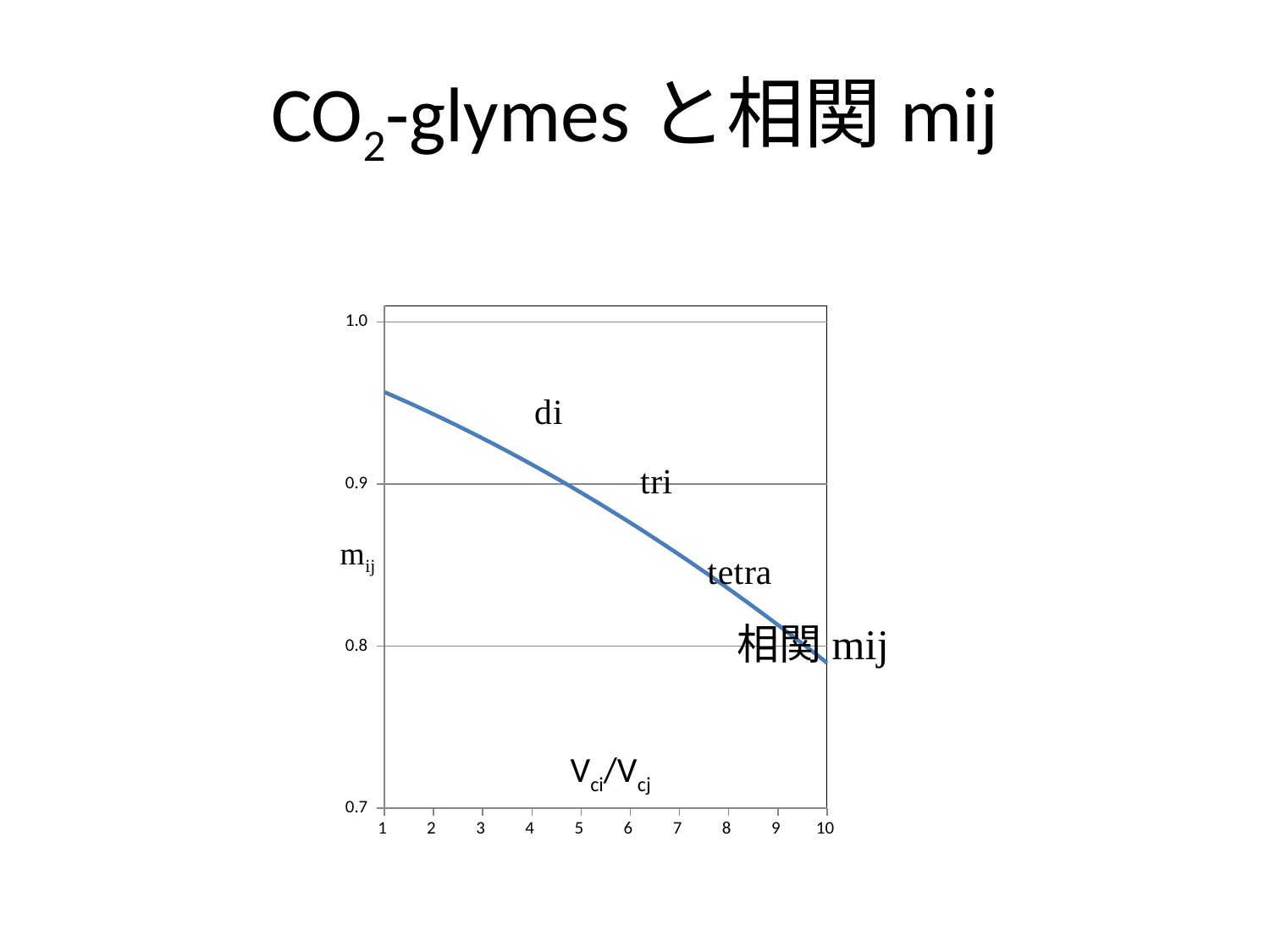
Does the plotted curve rise or fall as V_ci/V_cj increases from 1 to 10? fall Which three text annotations are placed along the curve in the chart? di, tri, tetra Is the value of m_ij at V_ci/V_cj = 7 greater or less than 0.9? less What kind of chart is shown on the slide? line chart Is the value of m_ij at V_ci/V_cj = 8 greater or less than 0.8? greater Is the value of m_ij at V_ci/V_cj = 3 greater or less than 0.9? greater How many tick labels are shown on the x axis of the chart? 10 What is the label on the x axis of the chart? V_ci/V_cj